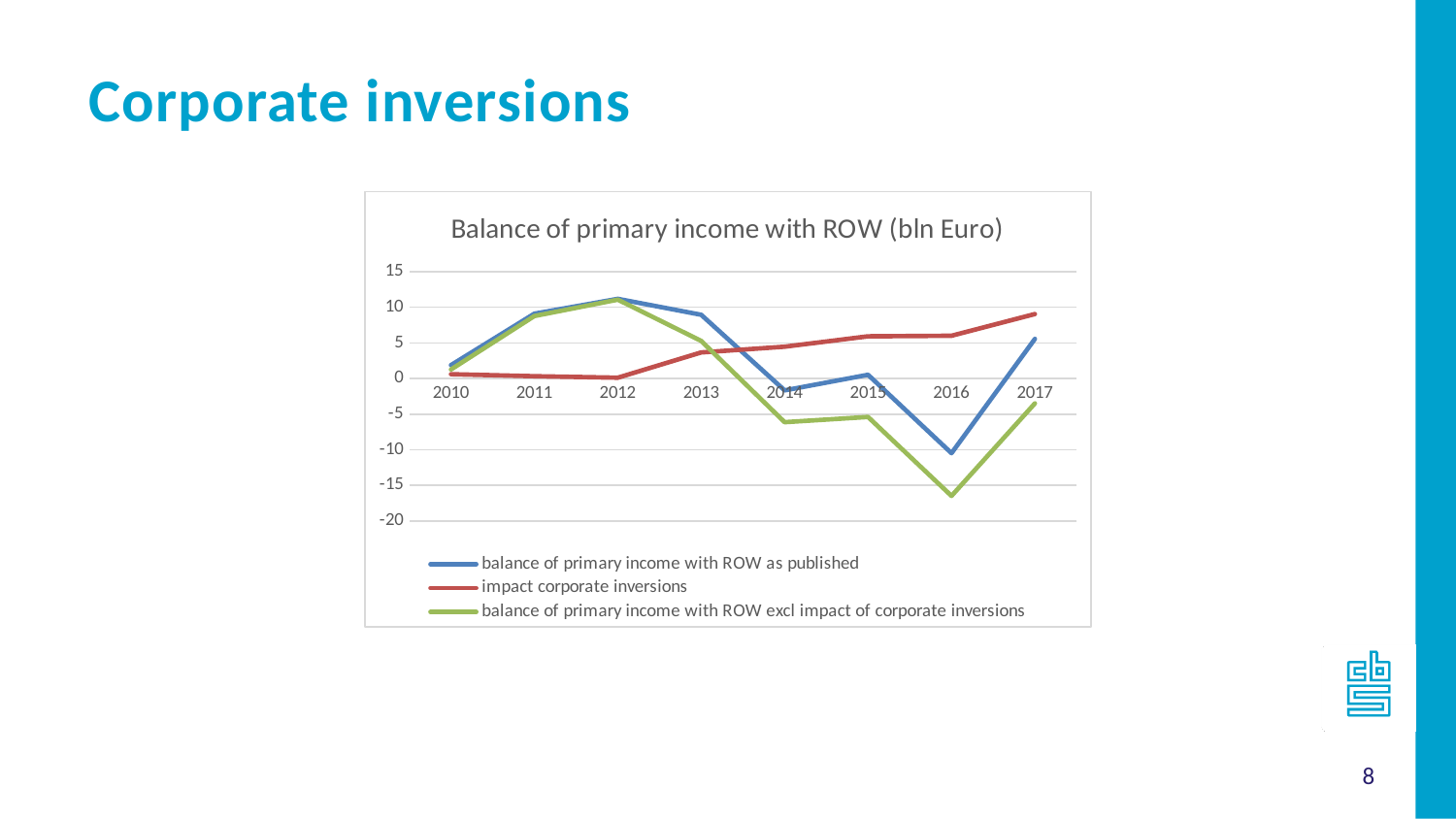
In which year is the 'impact corporate inversions' series at its highest? 2017 Is the 2016 value for 'balance of primary income with ROW excl impact of corporate inversions' greater or less than -15? less Is the 2016 value for 'balance of primary income with ROW as published' greater or less than -15? greater Is the 2017 value for 'impact corporate inversions' greater or less than 5? greater In which year is the 'balance of primary income with ROW as published' series at its lowest? 2016 In 2016, which series has the larger value: 'balance of primary income with ROW as published' or 'balance of primary income with ROW excl impact of corporate inversions'? balance of primary income with ROW as published What kind of chart is shown on the slide? line chart How many series does the legend list? 3 Does the 'impact corporate inversions' series rise or fall from 2012 to 2017? rise In which year is the 'balance of primary income with ROW excl impact of corporate inversions' series at its lowest? 2016 How many years are plotted along the x axis? 8 What is the title of the chart? Balance of primary income with ROW (bln Euro)